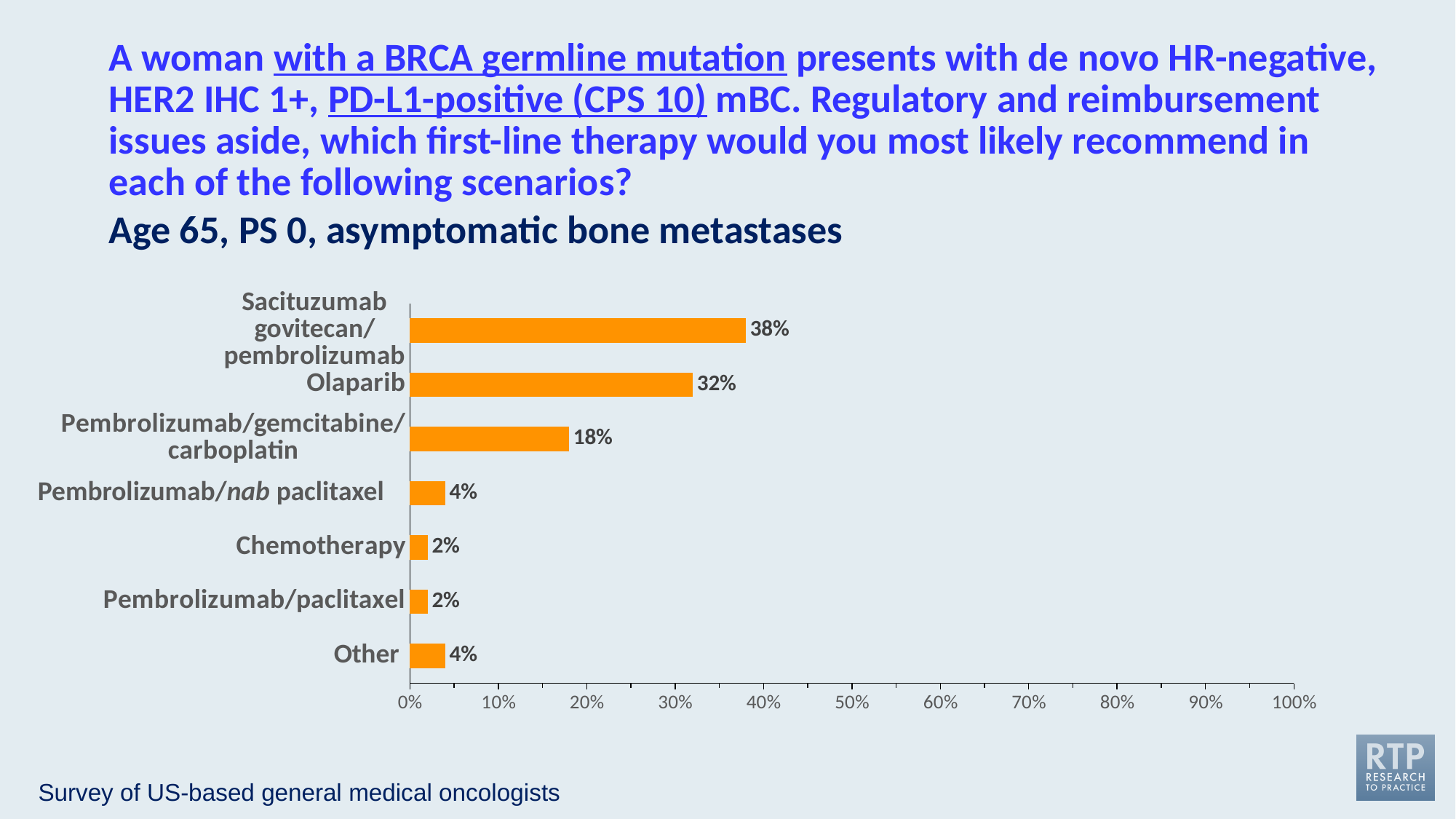
What kind of chart is shown on the slide? Bar chart What percentage of respondents chose olaparib? 32% What is the value for pembrolizumab/gemcitabine/carboplatin? 18% What is the difference in percentage points between sacituzumab govitecan/pembrolizumab and olaparib? 6 What is the value for chemotherapy? 2% Which therapy option has the highest percentage? Sacituzumab govitecan/pembrolizumab What percentage of respondents chose sacituzumab govitecan/pembrolizumab? 38% What is the value for pembrolizumab/nab paclitaxel? 4% What is the maximum value shown on the x axis? 100% What is the difference in percentage points between olaparib and pembrolizumab/gemcitabine/carboplatin? 14 Which is larger, the value for pembrolizumab/nab paclitaxel or the value for chemotherapy? Pembrolizumab/nab paclitaxel How many therapy options are shown on the chart? 7